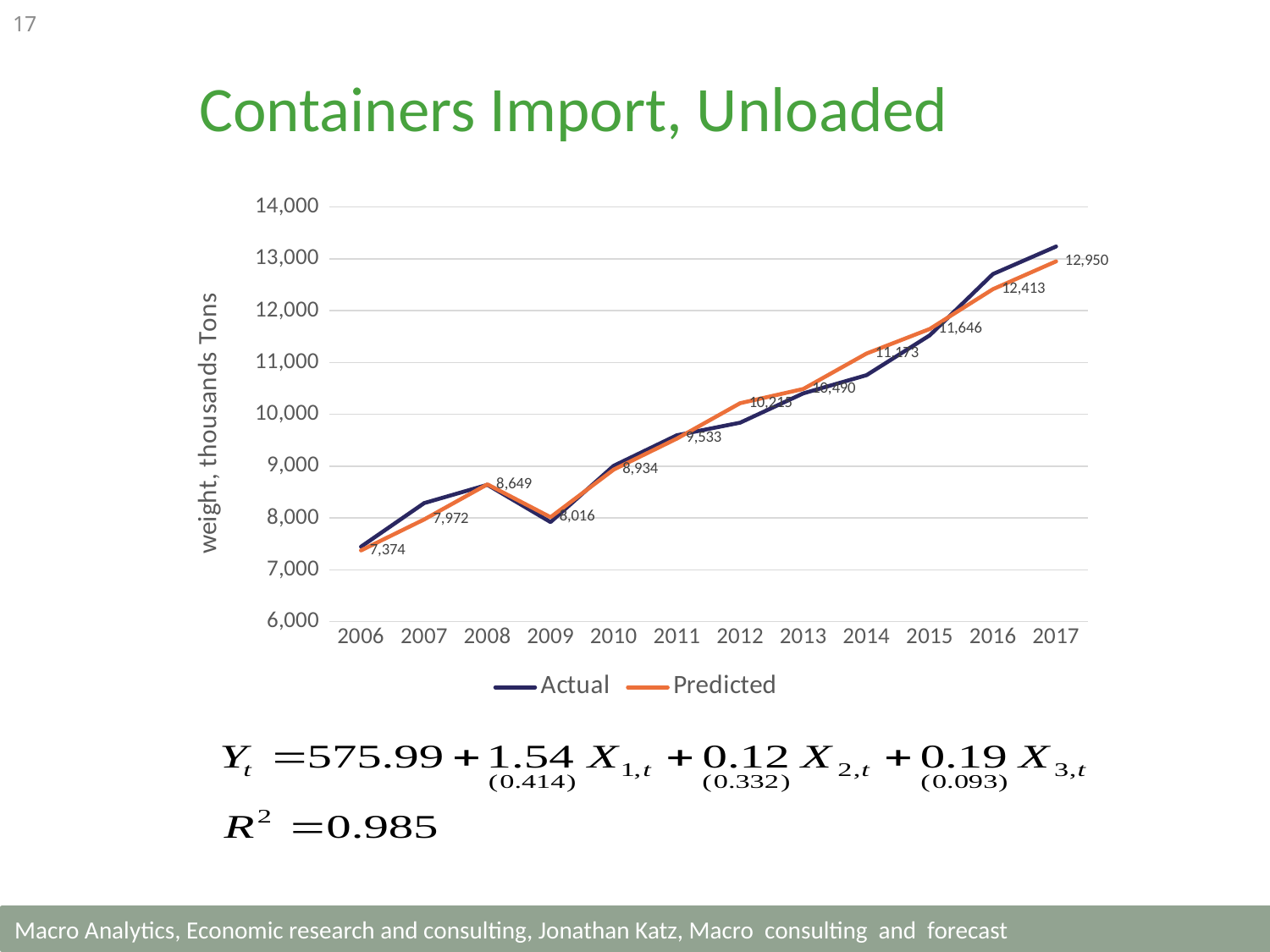
What kind of chart is shown on the slide? line chart What is the Predicted value for 2009? 8,016 What is the title of the y axis? weight, thousands Tons How many series does the legend list? 2 What is the Predicted value for 2008? 8,649 What is the Predicted value for 2006? 7,374 What is the Predicted value for 2017? 12,950 Is the Actual value for 2017 greater or less than 13,000? greater What is the difference between the Predicted values for 2017 and 2006? 5,576 Which year has the lowest Predicted value? 2006 How many years are plotted on the x axis? 12 Do the values generally rise or fall from 2006 to 2017? rise